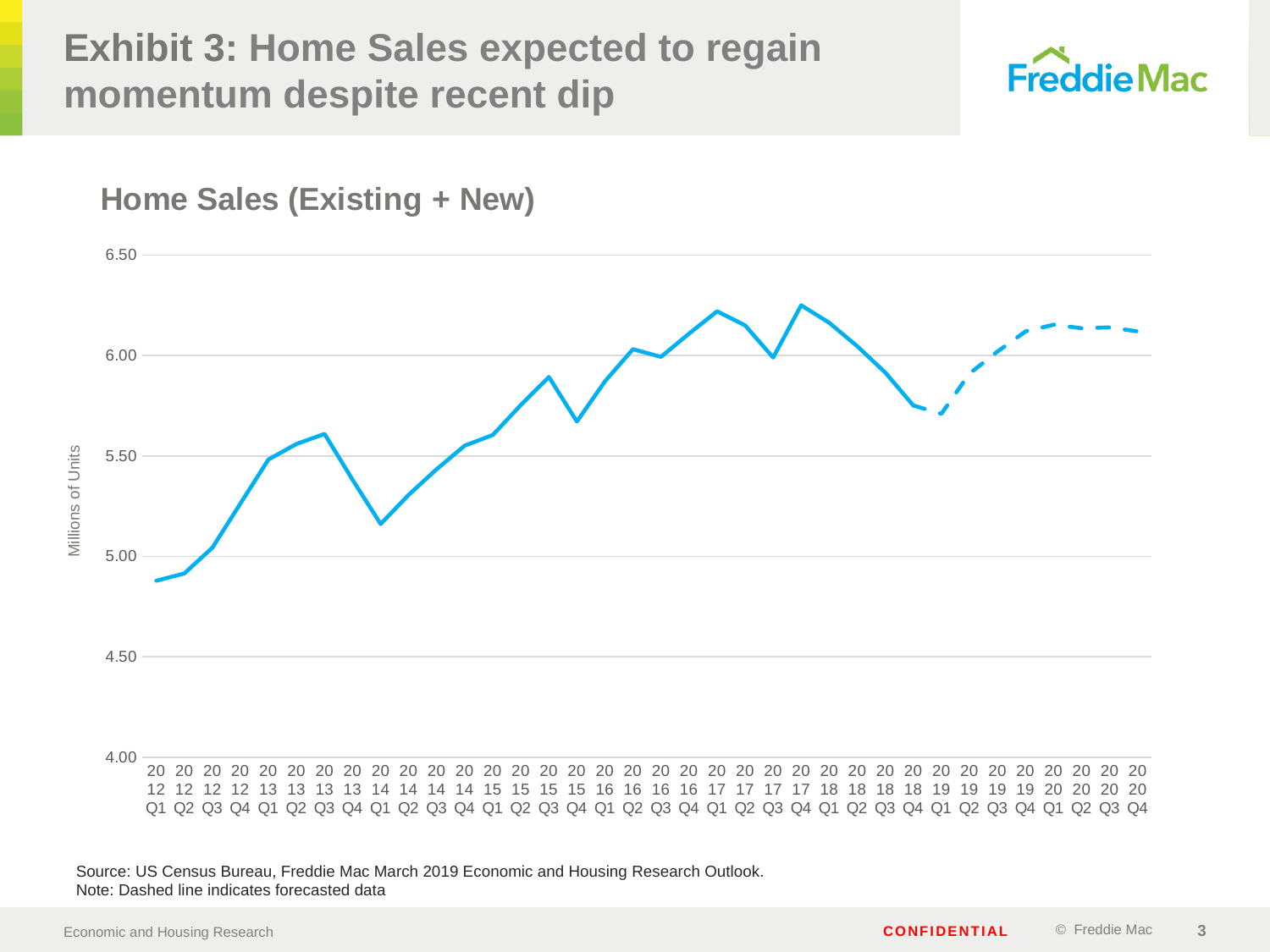
What is the label on the vertical axis of the chart? Millions of Units Overall, do home sales rise or fall from 2012 Q1 to 2020 Q4? Rise What kind of chart is shown on the slide? Line chart Is the value for 2014 Q1 greater or less than 5.00? greater Is the value for 2012 Q1 greater or less than 5.00? less Which quarter has the lowest value on the chart? 2012 Q1 Is the value for 2017 Q4 greater or less than 6.00? greater What is the title of the chart? Home Sales (Existing + New) Which is larger, the value for 2013 Q3 or the value for 2014 Q1? 2013 Q3 How many quarterly data points are plotted on the chart? 36